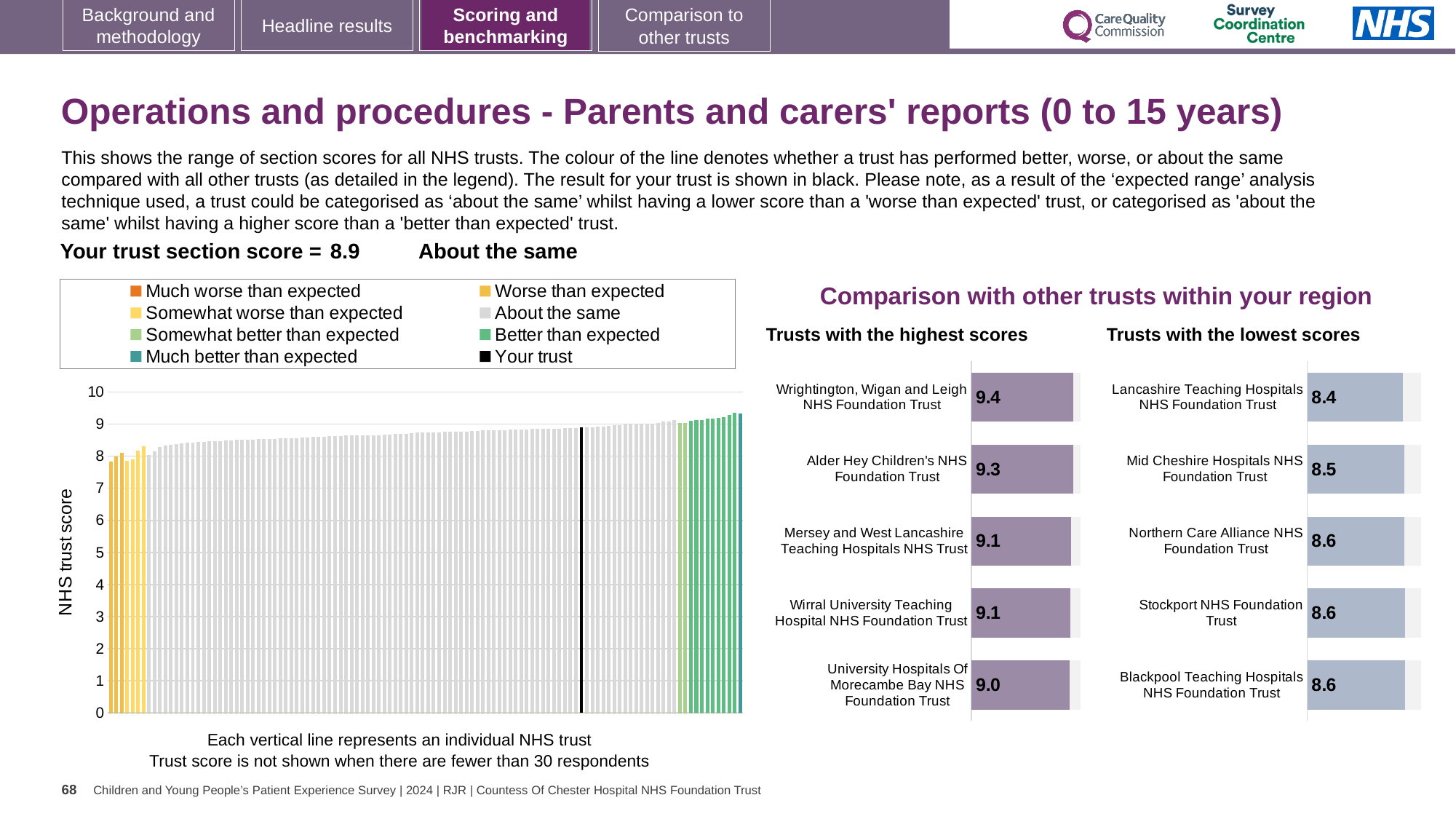
What type of chart is the NHS trust score chart on the left of the slide? Bar chart In the 'Trusts with the lowest scores' chart, what is the score for Stockport NHS Foundation Trust? 8.6 In the 'Trusts with the highest scores' chart, which trust has the highest score? Wrightington, Wigan and Leigh NHS Foundation Trust How many entries does the legend of the NHS trust score chart list? 8 In the 'Trusts with the highest scores' chart, what is the difference between the scores of Wrightington, Wigan and Leigh NHS Foundation Trust and University Hospitals Of Morecambe Bay NHS Foundation Trust? 0.4 In the NHS trust score chart on the left, do the values rise or fall from left to right? Rise In the 'Trusts with the highest scores' chart, what is the score for Wrightington, Wigan and Leigh NHS Foundation Trust? 9.4 In the 'Trusts with the lowest scores' chart, which has the larger score: Mid Cheshire Hospitals NHS Foundation Trust or Lancashire Teaching Hospitals NHS Foundation Trust? Mid Cheshire Hospitals NHS Foundation Trust How many trusts are shown in the 'Trusts with the highest scores' chart? 5 What is the section score for your trust shown in the NHS trust score chart? 8.9 In the 'Trusts with the lowest scores' chart, which trust has the lowest score? Lancashire Teaching Hospitals NHS Foundation Trust In the 'Trusts with the lowest scores' chart, what is the score for Lancashire Teaching Hospitals NHS Foundation Trust? 8.4